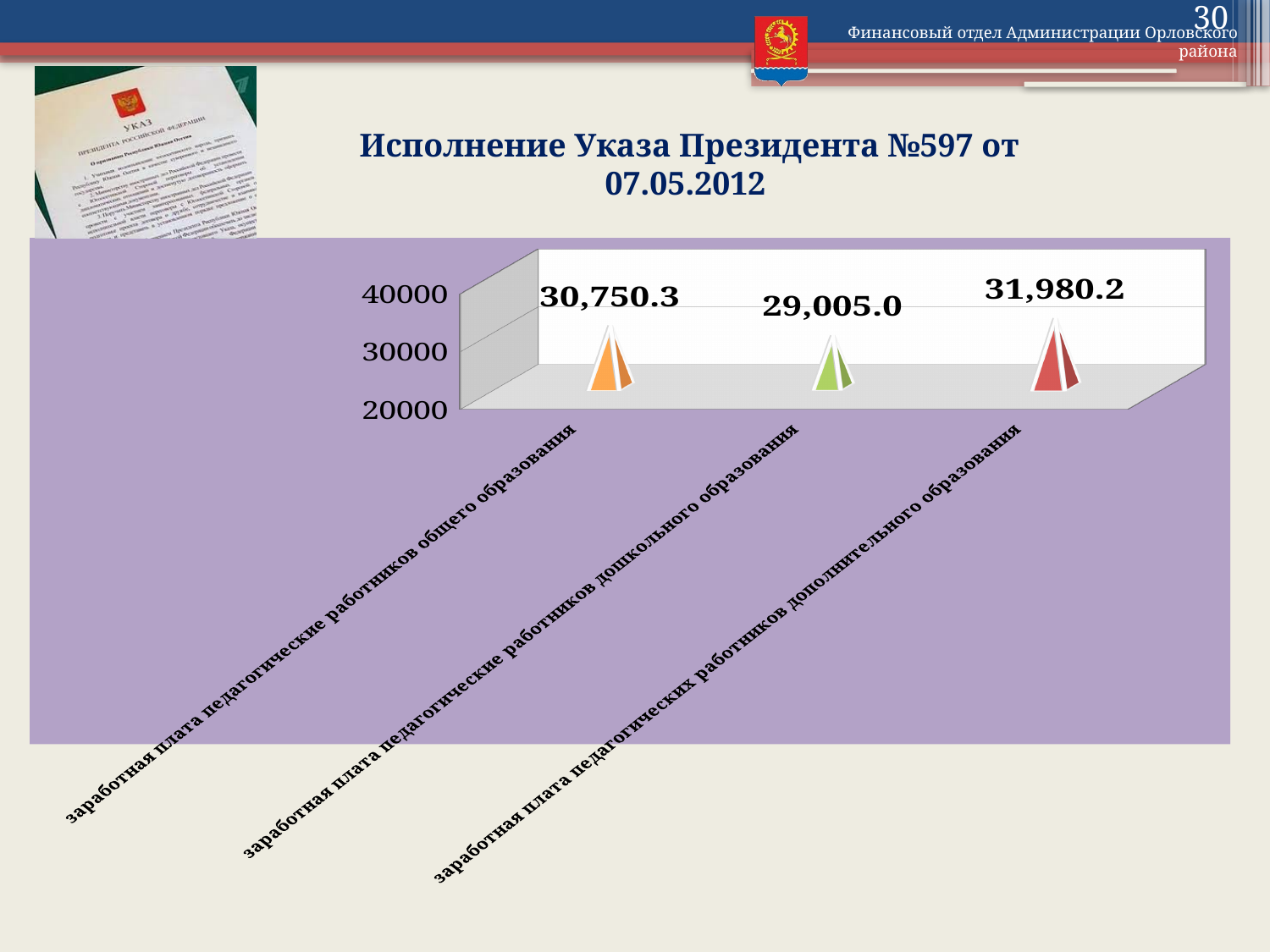
What is the value for заработная плата педагогические работников общего образования? 30,750.3 What is the value for заработная плата педагогические работников дошкольного образования? 29,005.0 Which category has the highest value? заработная плата педагогических работников дополнительного образования Which category has the lowest value? заработная плата педагогические работников дошкольного образования What is the title of the slide above the chart? Исполнение Указа Президента №597 от 07.05.2012 What kind of chart is shown on the slide? bar chart Is the value for дошкольного образования greater or less than 30000? less Which is larger: the value for общего образования or the value for дошкольного образования? общего образования What is the difference between the value for дополнительного образования and the value for общего образования? 1,229.9 How many categories are shown in the chart? 3 What is the difference between the value for общего образования and the value for дошкольного образования? 1,745.3 What is the value for заработная плата педагогических работников дополнительного образования? 31,980.2